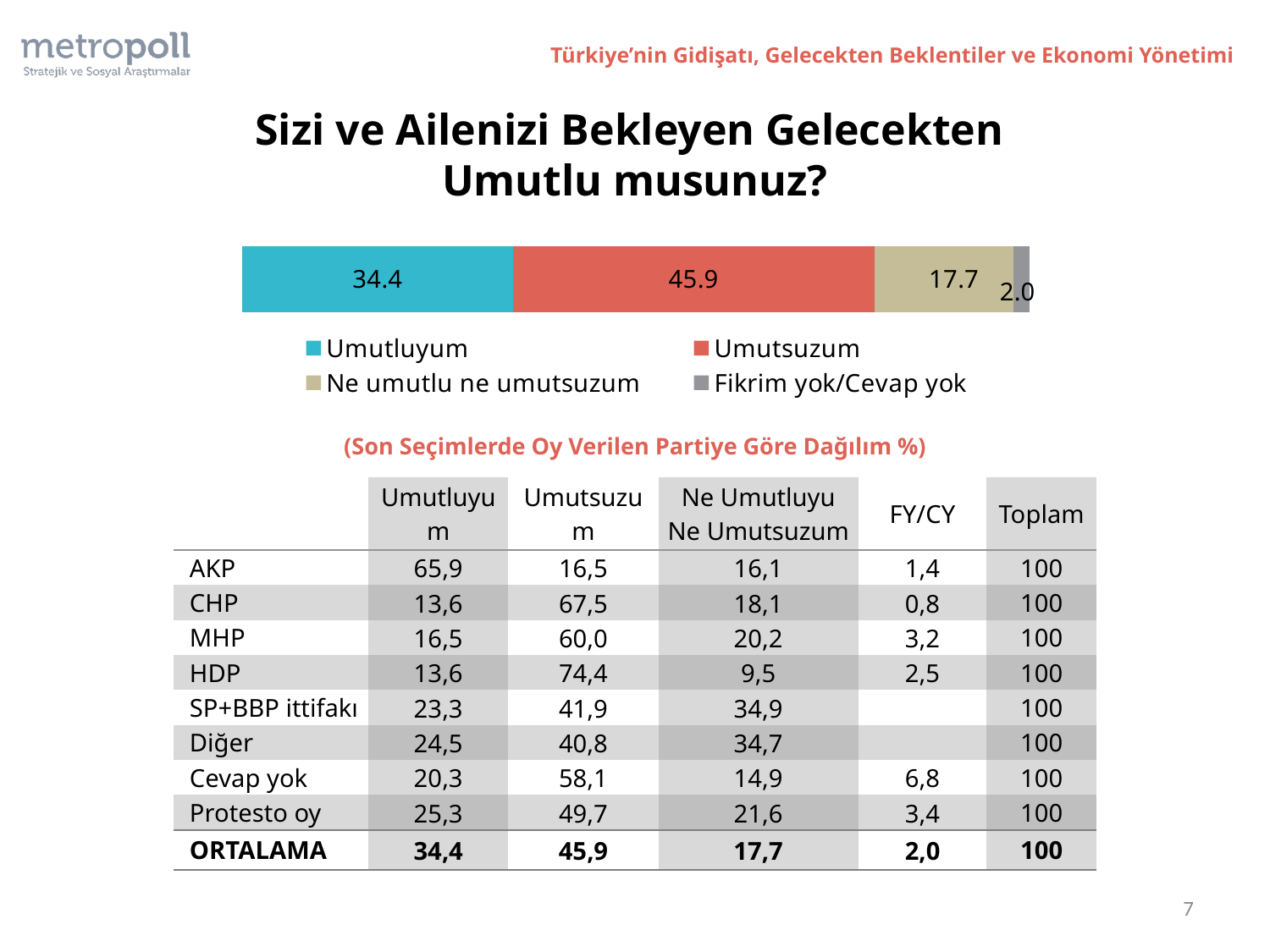
What is the total of all segments in the stacked bar? 100.0 What kind of chart is shown on the slide? Stacked bar chart Which legend category has the smallest segment in the stacked bar? Fikrim yok/Cevap yok What value is shown for the Umutsuzum segment of the stacked bar? 45.9 What value is shown for the Fikrim yok/Cevap yok segment of the stacked bar? 2.0 How many series does the chart legend list? 4 What is the difference between the Umutsuzum and Umutluyum values in the stacked bar? 11.5 Which legend category has the largest segment in the stacked bar? Umutsuzum What value is shown for the Umutluyum segment of the stacked bar? 34.4 What value is shown for the Ne umutlu ne umutsuzum segment of the stacked bar? 17.7 What colour is the Umutsuzum segment in the stacked bar? Red Which is larger in the stacked bar, Umutluyum or Ne umutlu ne umutsuzum? Umutluyum